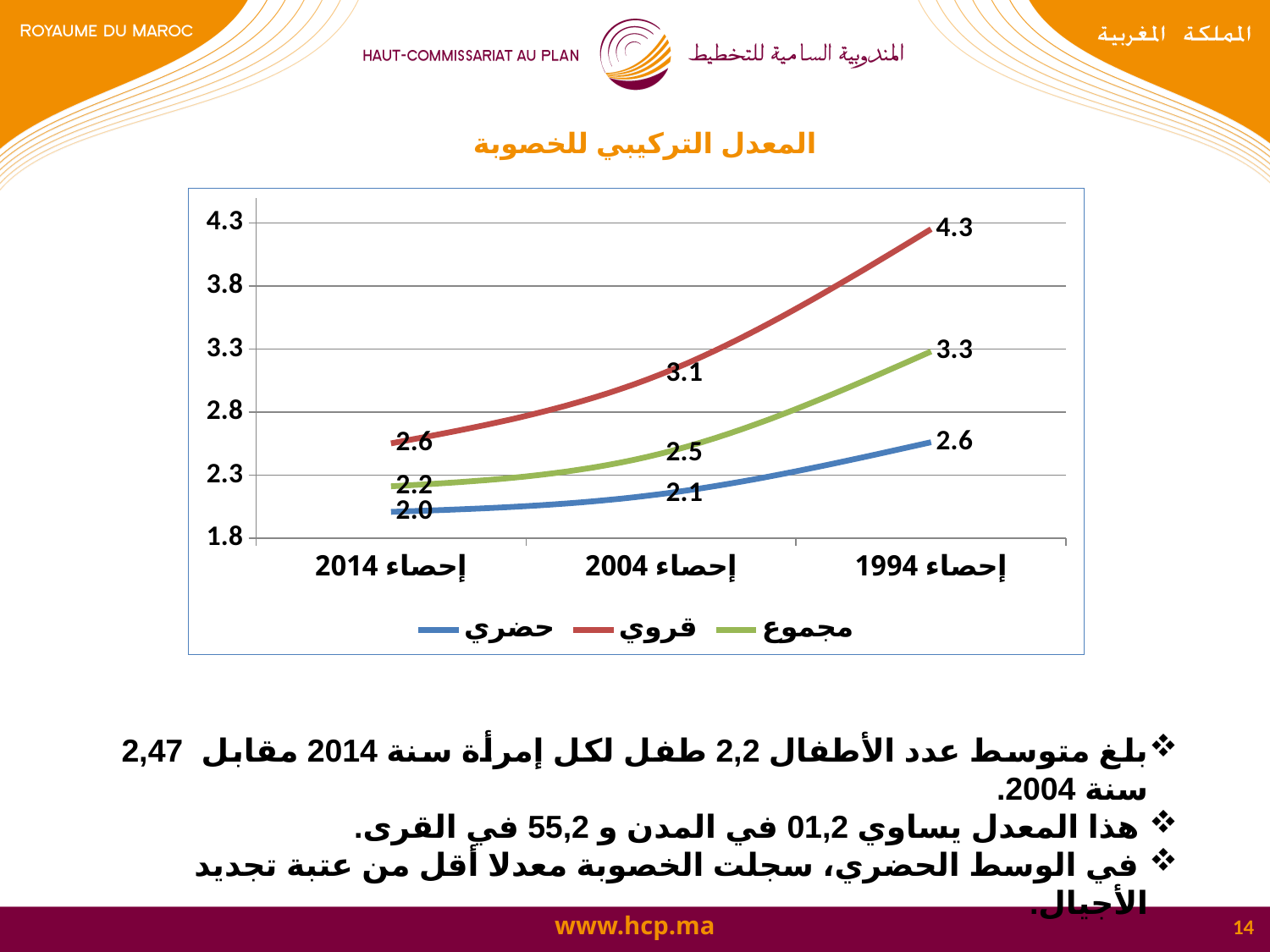
What is the value of the قروي series at إحصاء 2004? 3.1 Which is larger: the مجموع value at إحصاء 2014 or the حضري value at إحصاء 2004? مجموع at إحصاء 2014 What is the difference between the قروي and حضري values at إحصاء 1994? 1.7 How many series does the legend list? 3 Which series has the highest value at إحصاء 1994? قروي From إحصاء 1994 to إحصاء 2014, does the قروي series rise or fall? fall What is the value of the مجموع series at إحصاء 2004? 2.5 What is the value of the قروي series at إحصاء 1994? 4.3 What is the value of the حضري series at إحصاء 2014? 2.0 What type of chart is shown on the slide? line chart How many census points are shown on the x axis? 3 Which series has the lowest value at إحصاء 2014? حضري